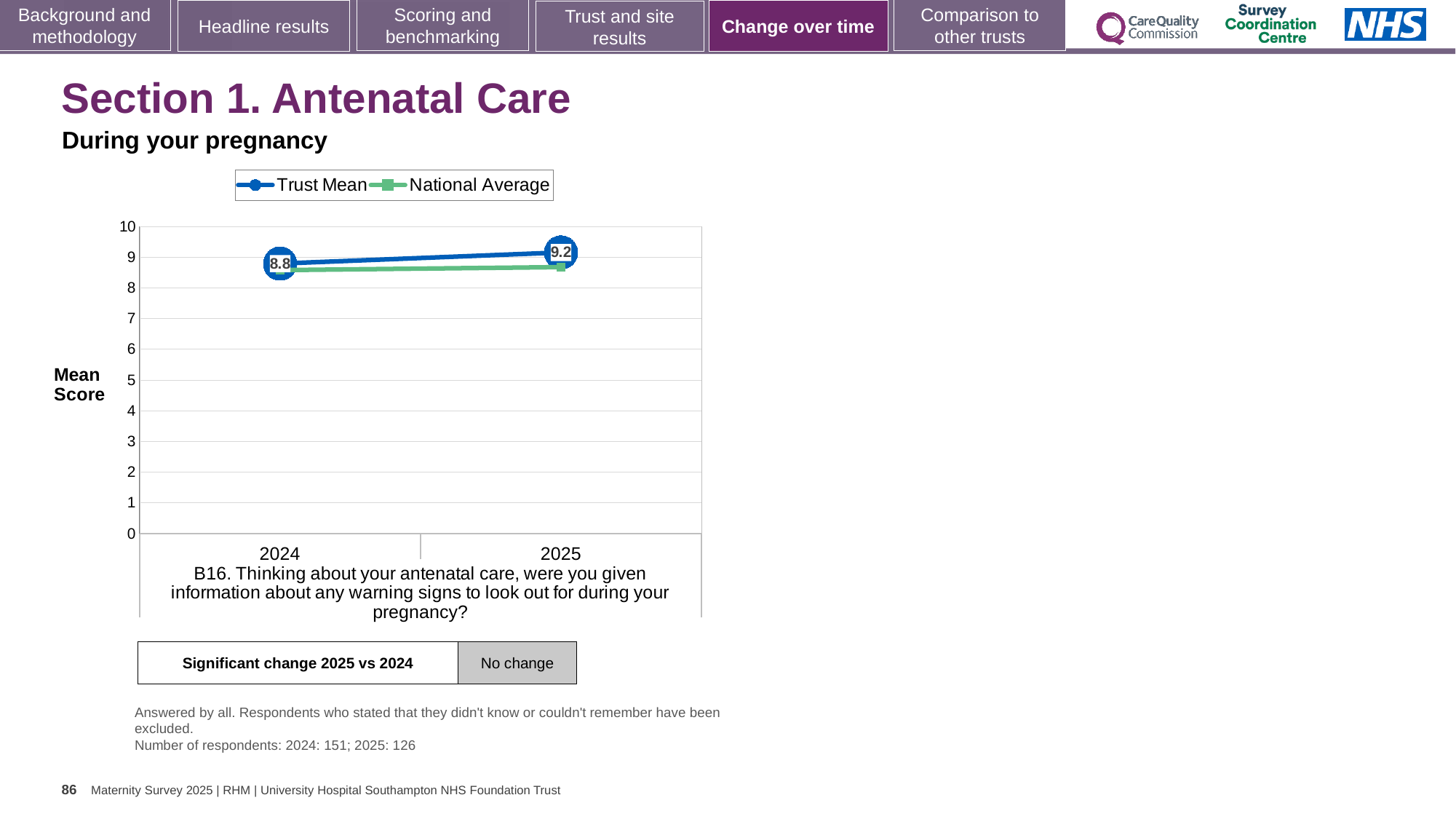
What is the Trust Mean score for 2024? 8.8 Is the National Average value for 2024 greater or less than 8? greater In 2025, which is larger: the Trust Mean or the National Average? Trust Mean Is the National Average value for 2025 greater or less than 9? less Does the Trust Mean rise or fall from 2024 to 2025? Rise How many series does the chart legend list? 2 In which year is the Trust Mean score highest? 2025 How many years are plotted on the x axis of the chart? 2 What is the difference between the Trust Mean score in 2025 and in 2024? 0.4 What kind of chart is shown on the slide? Line chart What is the Trust Mean score for 2025? 9.2 In which year is the Trust Mean score lowest? 2024